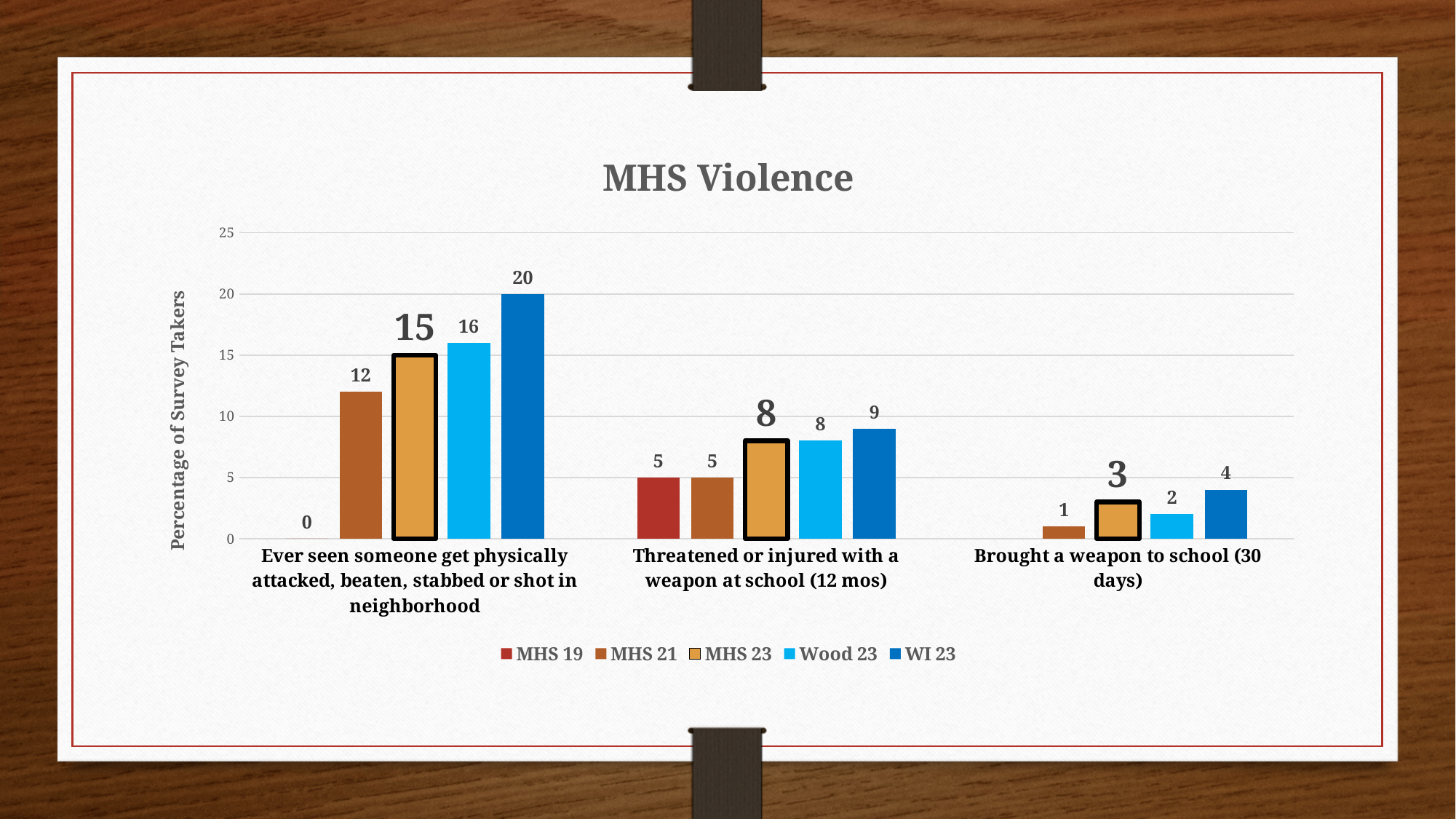
What is the value for MHS 23 in the 'Threatened or injured with a weapon at school (12 mos)' category? 8 How many categories are shown on the x axis? 3 What is the value for MHS 21 in the 'Brought a weapon to school (30 days)' category? 1 How many series does the legend list? 5 What is the label of the y axis? Percentage of Survey Takers What type of chart is shown on the slide? bar chart What is the title of the chart? MHS Violence Which series has the lowest value in the 'Brought a weapon to school (30 days)' category among the bars shown? MHS 21 Which series has the highest value in the 'Ever seen someone get physically attacked, beaten, stabbed or shot in neighborhood' category? WI 23 What is the difference between the WI 23 and MHS 21 values in the 'Ever seen someone get physically attacked, beaten, stabbed or shot in neighborhood' category? 8 What is the value for WI 23 in the 'Ever seen someone get physically attacked, beaten, stabbed or shot in neighborhood' category? 20 Which is larger in the 'Brought a weapon to school (30 days)' category: MHS 23 or Wood 23? MHS 23